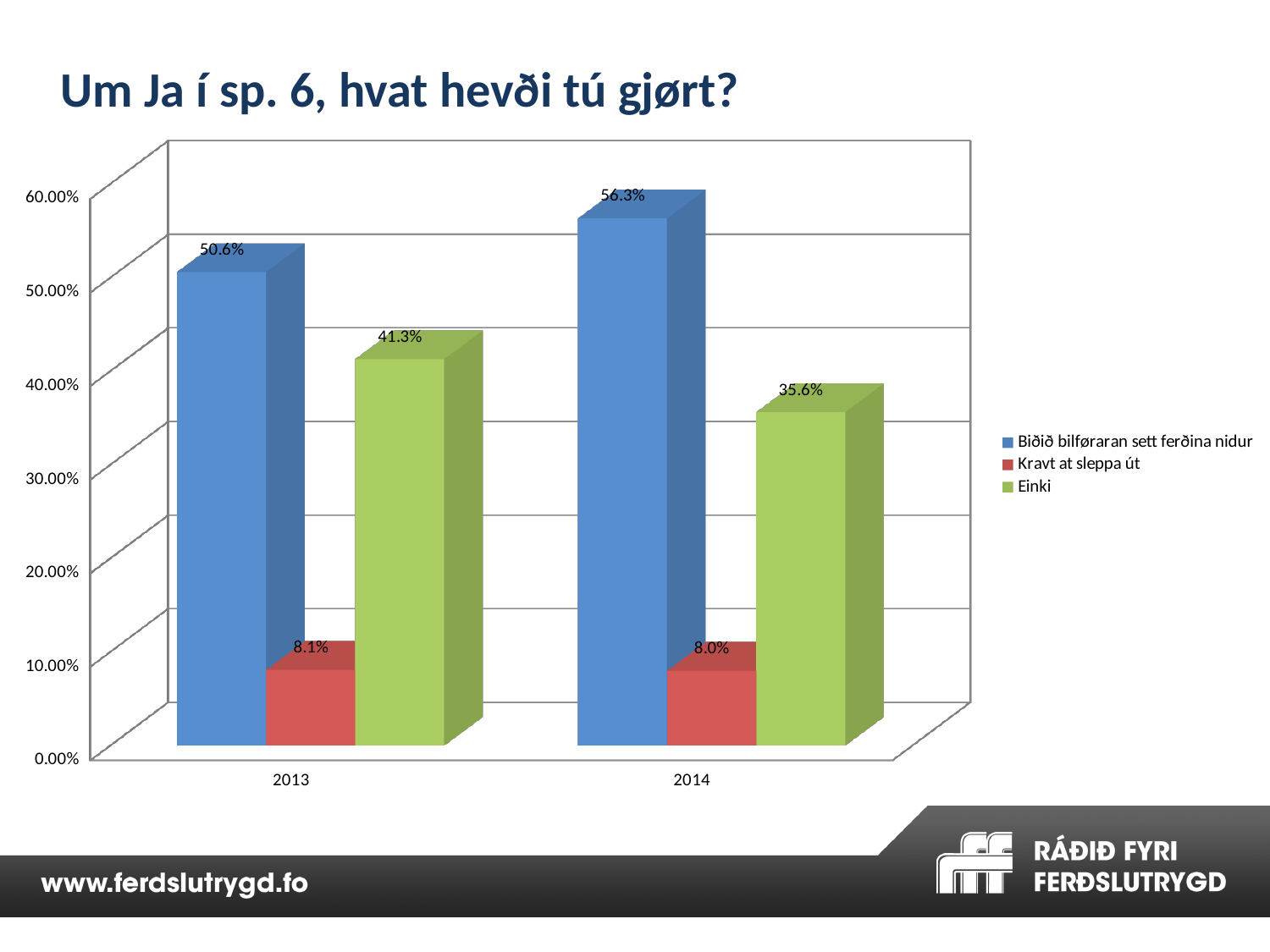
How many categories are shown on the x axis? 2 Does the value for "Biðið bilføraran sett ferðina niður" rise or fall from 2013 to 2014? Rise What is the value for "Biðið bilføraran sett ferðina niður" in 2013? 50.6% Which series has the highest value in 2014? Biðið bilføraran sett ferðina niður What is the difference between the "Biðið bilføraran sett ferðina niður" values for 2014 and 2013? 5.7% Which is larger: "Einki" in 2013 or "Einki" in 2014? Einki in 2013 Which series has the lowest value in 2013? Kravt at sleppa út What kind of chart is shown on the slide? Bar chart How many series does the legend list? 3 What is the difference between the "Einki" values for 2013 and 2014? 5.7% What is the value for "Kravt at sleppa út" in 2013? 8.1% What is the value for "Einki" in 2014? 35.6%